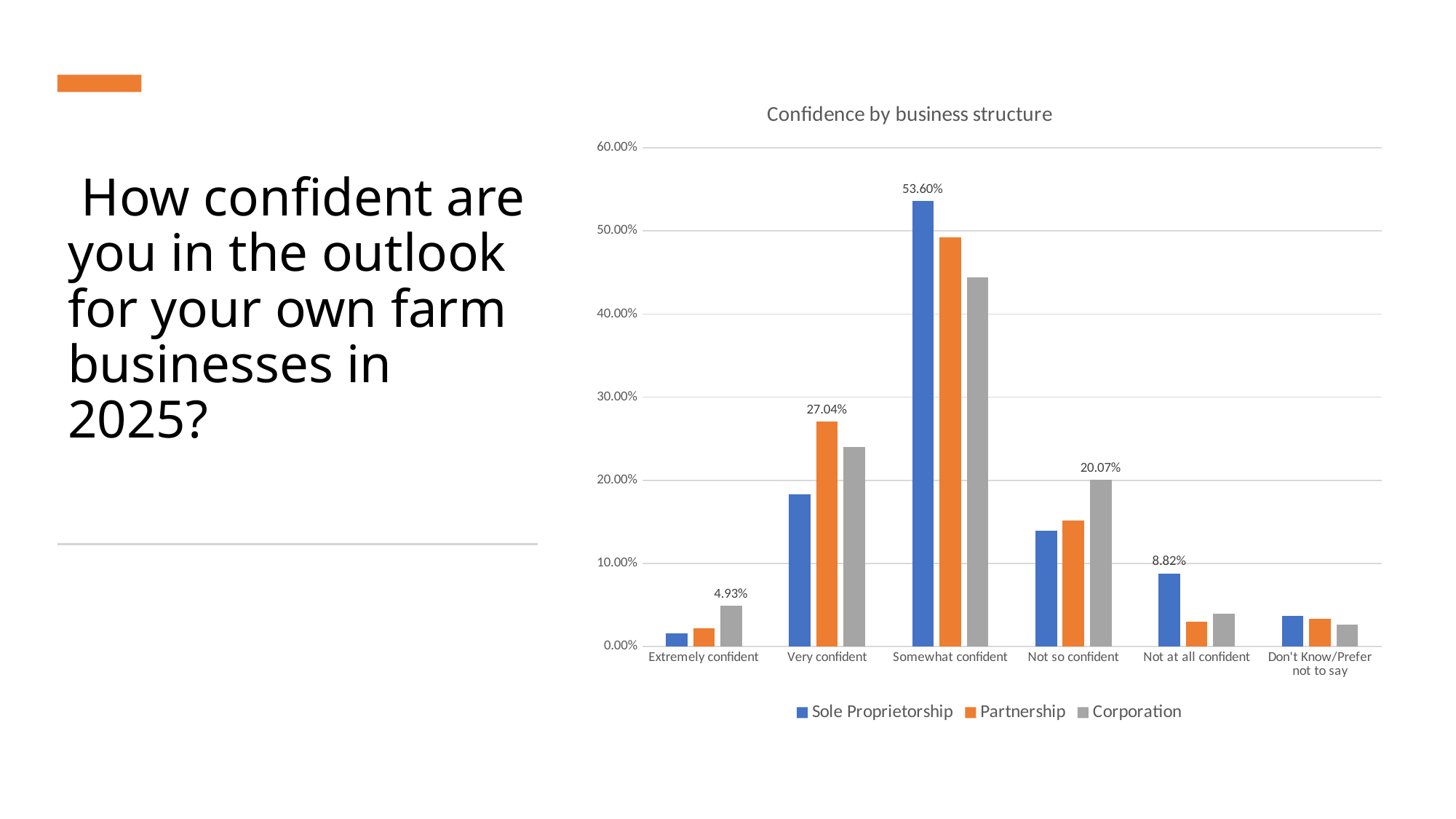
What is the value for Partnership in the Very confident category? 27.04% Is the value for Corporation in the Somewhat confident category greater or less than 40.00%? greater What is the value for Corporation in the Not so confident category? 20.07% What is the value for Sole Proprietorship in the Not at all confident category? 8.82% What kind of chart is shown on the slide? Bar chart In the Very confident category, which is larger: Partnership or Corporation? Partnership How many categories are shown on the x axis? 6 Which category has the highest value for Sole Proprietorship? Somewhat confident How many series does the legend list? 3 What is the value for Sole Proprietorship in the Somewhat confident category? 53.60% What is the difference between the Sole Proprietorship values for Somewhat confident and Not at all confident? 44.78% What is the value for Corporation in the Extremely confident category? 4.93%